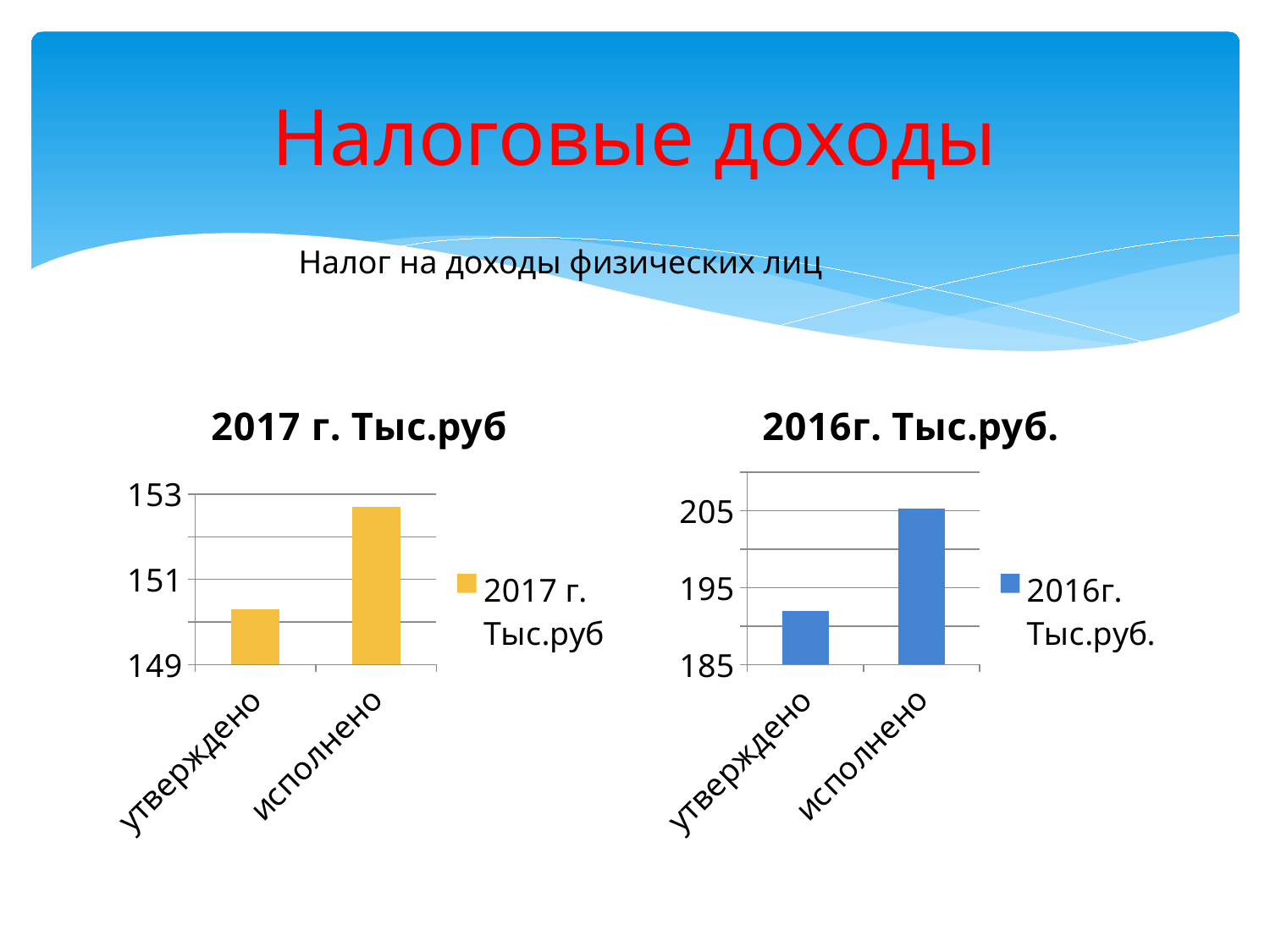
In the chart titled "2016г. Тыс.руб.", is the value for утверждено larger or smaller than the value for исполнено? smaller What kind of chart is the chart titled "2016г. Тыс.руб."? bar chart In the chart titled "2016г. Тыс.руб.", which category has the higher value? исполнено In the chart titled "2016г. Тыс.руб.", is the value for исполнено greater or less than 195? greater In the chart titled "2017 г. Тыс.руб", is the value for утверждено greater or less than 151? less In the chart titled "2016г. Тыс.руб.", is the value for утверждено greater or less than 195? less How many series does the legend of the chart titled "2017 г. Тыс.руб" list? 1 In the chart titled "2017 г. Тыс.руб", which category has the higher value? исполнено How many categories are shown in the chart titled "2017 г. Тыс.руб"? 2 In the chart titled "2017 г. Тыс.руб", which category has the lower value? утверждено What colour are the bars in the chart titled "2016г. Тыс.руб."? blue